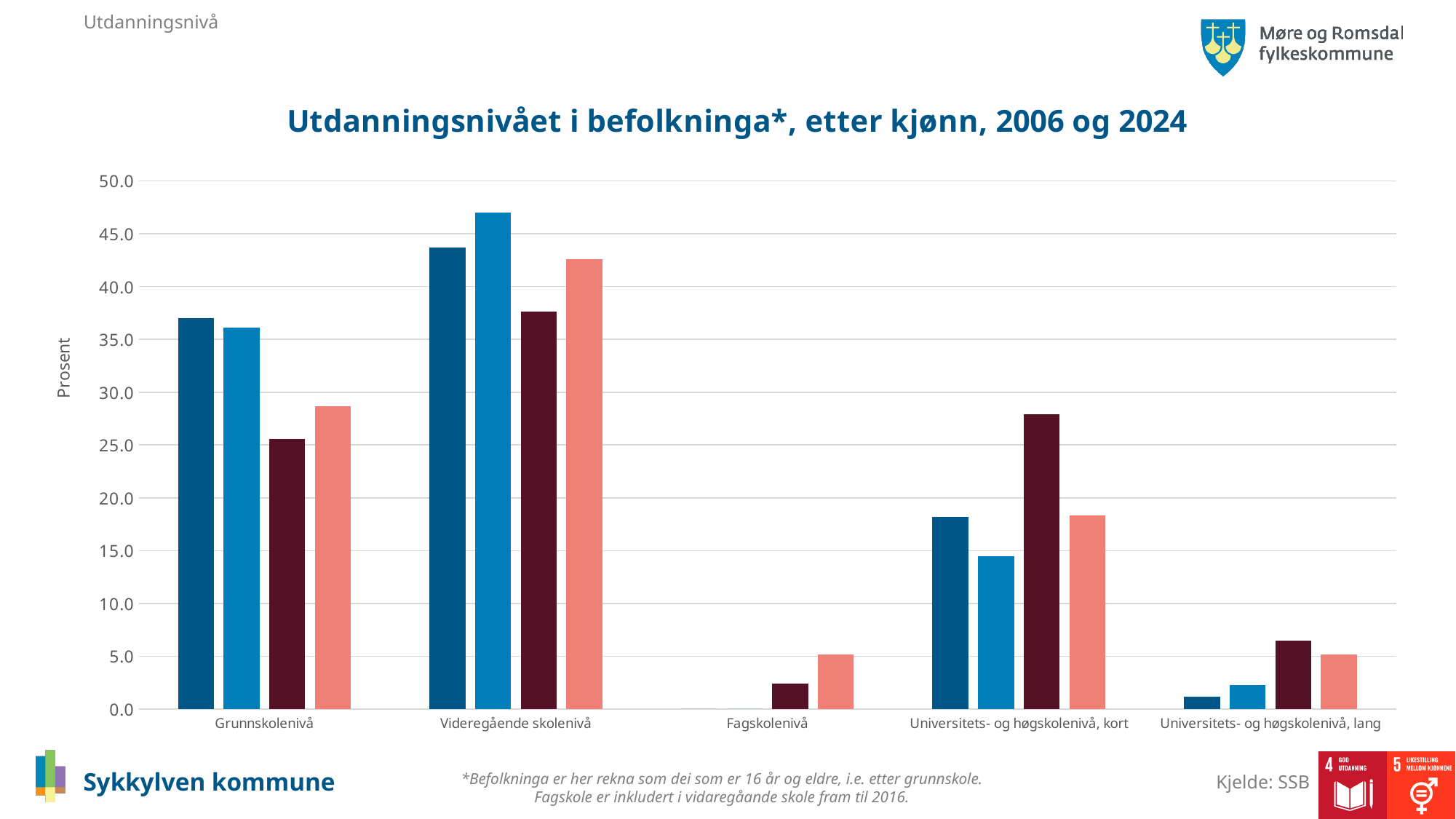
For Grunnskolenivå, which is larger: the dark blue bar or the dark red bar? the dark blue bar What kind of chart is shown on the slide? bar chart Is the dark red bar for Grunnskolenivå greater or less than 30? less Is the dark blue bar for Grunnskolenivå greater or less than 35? greater Which category contains the tallest bar in the chart? Videregående skolenivå What is the title of the chart? Utdanningsnivået i befolkninga*, etter kjønn, 2006 og 2024 Is the dark red bar for Universitets- og høgskolenivå, kort greater or less than 25? greater How many education-level categories are shown on the x axis? 5 For Universitets- og høgskolenivå, kort, which is larger: the light blue bar or the dark red bar? the dark red bar What source is cited for the chart? SSB